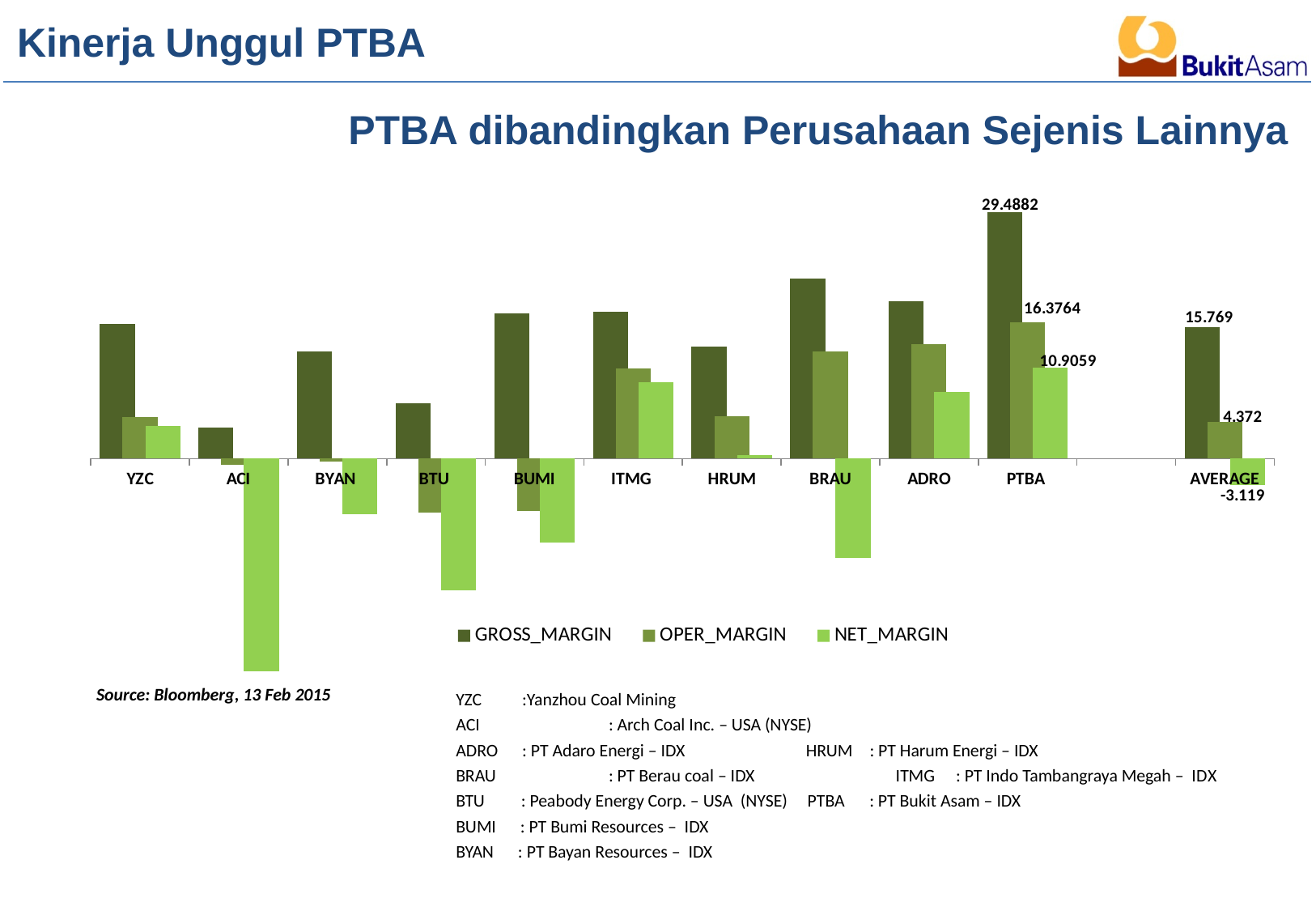
What kind of chart is shown? Bar chart How many categories are shown on the x axis? 11 What is the difference between PTBA's GROSS_MARGIN and AVERAGE's GROSS_MARGIN? 13.7192 What is the NET_MARGIN value for AVERAGE? -3.119 What is the GROSS_MARGIN value for PTBA? 29.4882 How many series does the legend list? 3 What is the NET_MARGIN value for PTBA? 10.9059 Which company has the lowest NET_MARGIN? ACI What is the OPER_MARGIN value for PTBA? 16.3764 What is the GROSS_MARGIN value for AVERAGE? 15.769 Which company has the highest GROSS_MARGIN? PTBA Which is larger, the GROSS_MARGIN of BRAU or of ADRO? BRAU